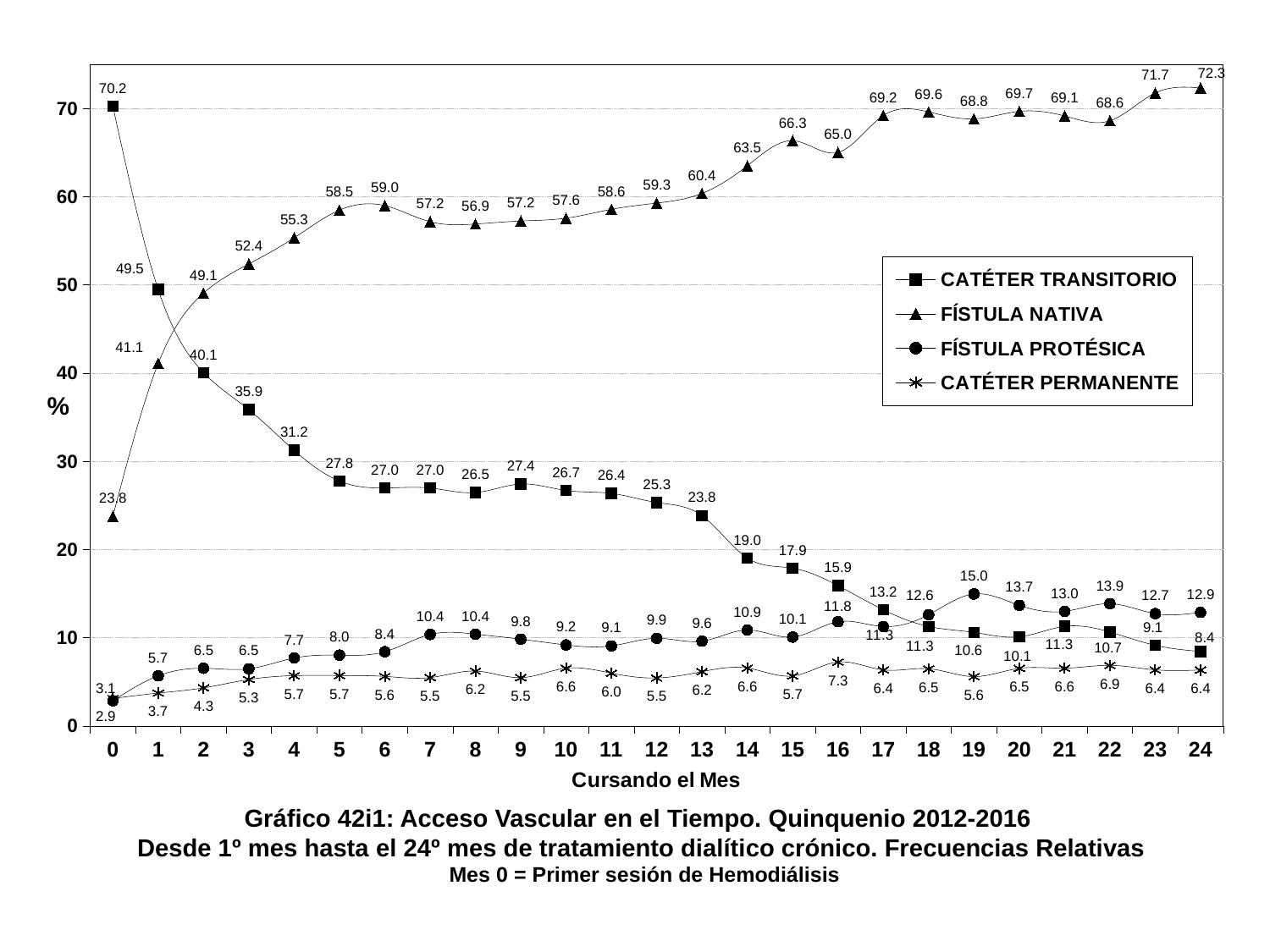
Which series has the larger value at month 1, CATÉTER TRANSITORIO or FÍSTULA NATIVA? CATÉTER TRANSITORIO What is the value for CATÉTER TRANSITORIO at month 0? 70.2 What is the difference between CATÉTER TRANSITORIO and FÍSTULA NATIVA at month 0? 46.4 What is the label of the x axis? Cursando el Mes Does the CATÉTER TRANSITORIO series rise or fall from month 0 to month 24? fall What is the value for FÍSTULA PROTÉSICA at month 19? 15.0 How many series does the legend list? 4 What type of chart is shown on the slide? line chart What is the value for CATÉTER PERMANENTE at month 16? 7.3 What is the value for FÍSTULA NATIVA at month 24? 72.3 At which month is CATÉTER TRANSITORIO at its lowest value? 24 At which month does FÍSTULA NATIVA reach its highest value? 24